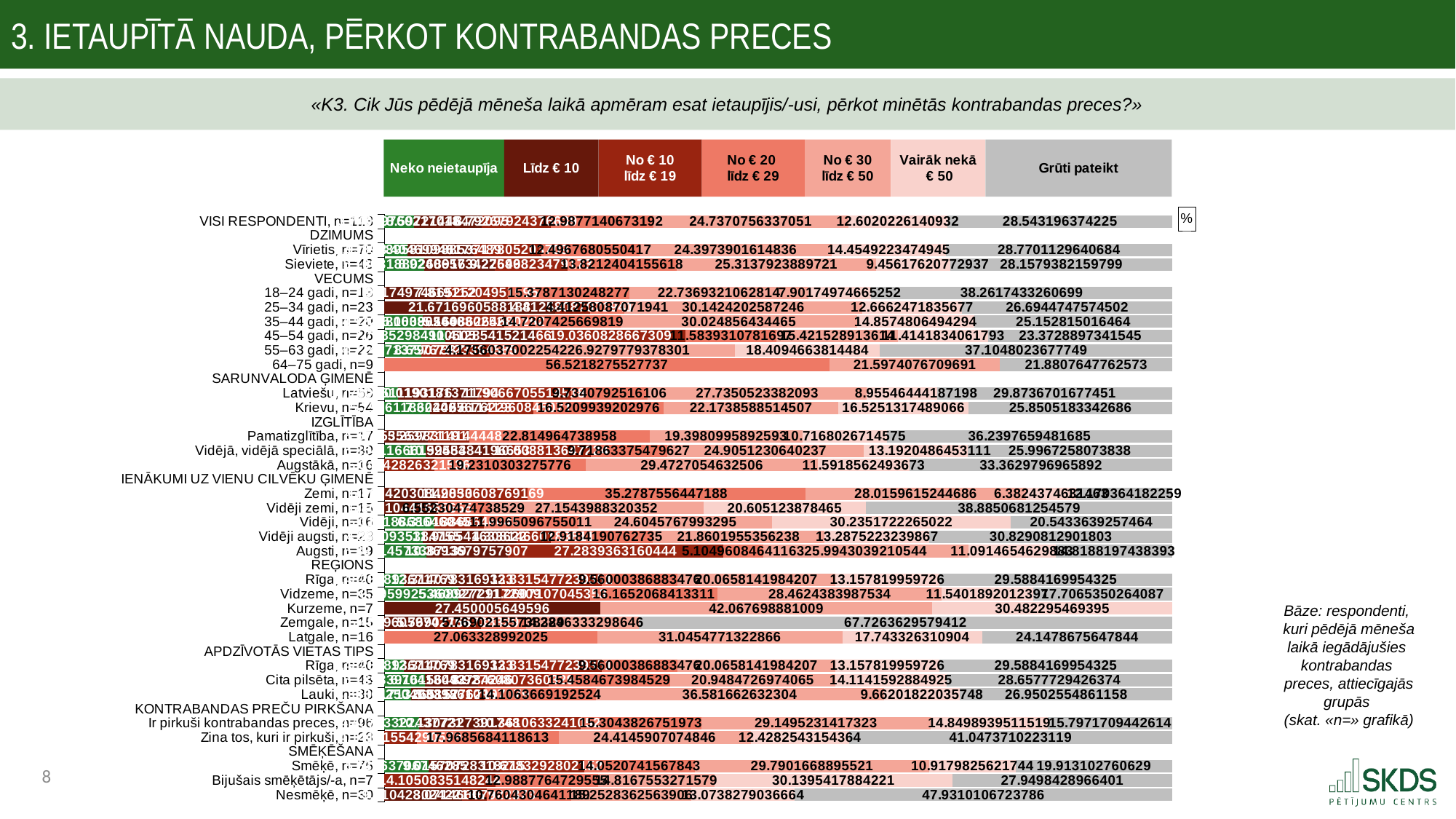
Which colour represents the "Neko neietaupīja" series in the legend? green What kind of chart is shown on the slide? bar chart What is the "Grūti pateikt" value for Zemgale, n=15? 67.7263629579412 Which is larger for Latgale, n=16: the "No € 20 līdz € 29" value or the "Grūti pateikt" value? No € 20 līdz € 29 What is the "Vairāk nekā € 50" value for Vidēji, n=16? 30.2351722265022 What is the "No € 20 līdz € 29" value for 64–75 gadi, n=9? 56.5218275527737 How many series does the legend list? 7 What is the "Grūti pateikt" value for Nesmēķē, n=30? 47.9310106723786 What is the "No € 30 līdz € 50" value for Latgale, n=16? 31.0454771322866